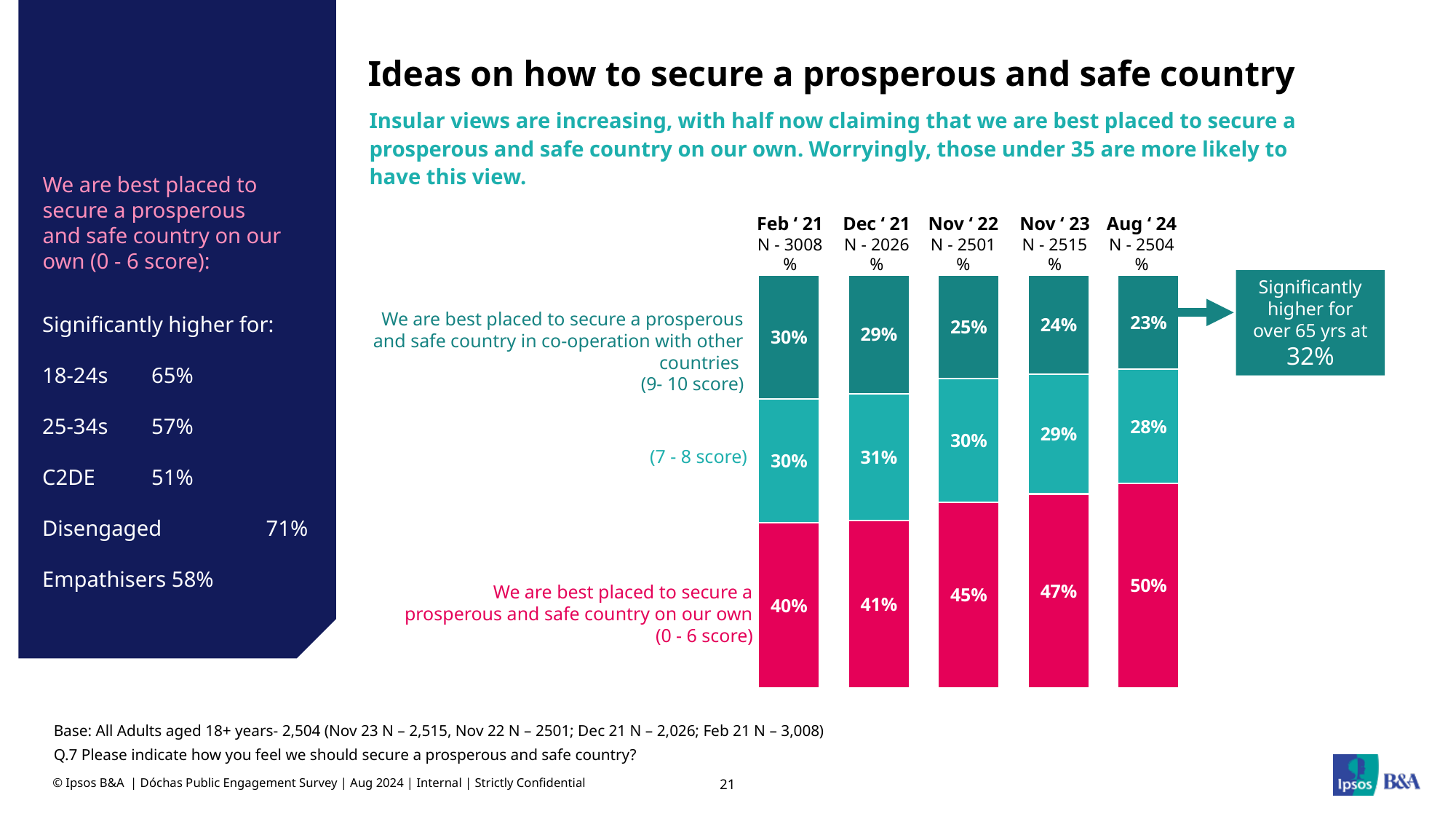
Which is larger in Nov ' 23: the 0 - 6 score share or the 7 - 8 score share? 0 - 6 score share How many survey waves are shown in the chart? 5 What is the total of the three segments for the Nov ' 22 bar? 100% In which survey wave was the share saying we are best placed on our own (0 - 6 score) highest? Aug ' 24 In which survey wave was the share giving a 9-10 score (co-operation with other countries) lowest? Aug ' 24 What percentage gave a 9-10 score (co-operation with other countries) in Feb ' 21? 30% By how many percentage points did the 0 - 6 score (on our own) share change from Feb ' 21 to Aug ' 24? 10 percentage points What is the sample size (N) shown for the Aug ' 24 wave? 2504 What type of chart is used on the slide? Stacked bar chart How does the share saying we are best placed on our own (0 - 6 score) change from Feb ' 21 to Aug ' 24? It rises What percentage gave a 7 - 8 score in Dec ' 21? 31% What percentage said we are best placed to secure a prosperous and safe country on our own (0 - 6 score) in Aug ' 24? 50%